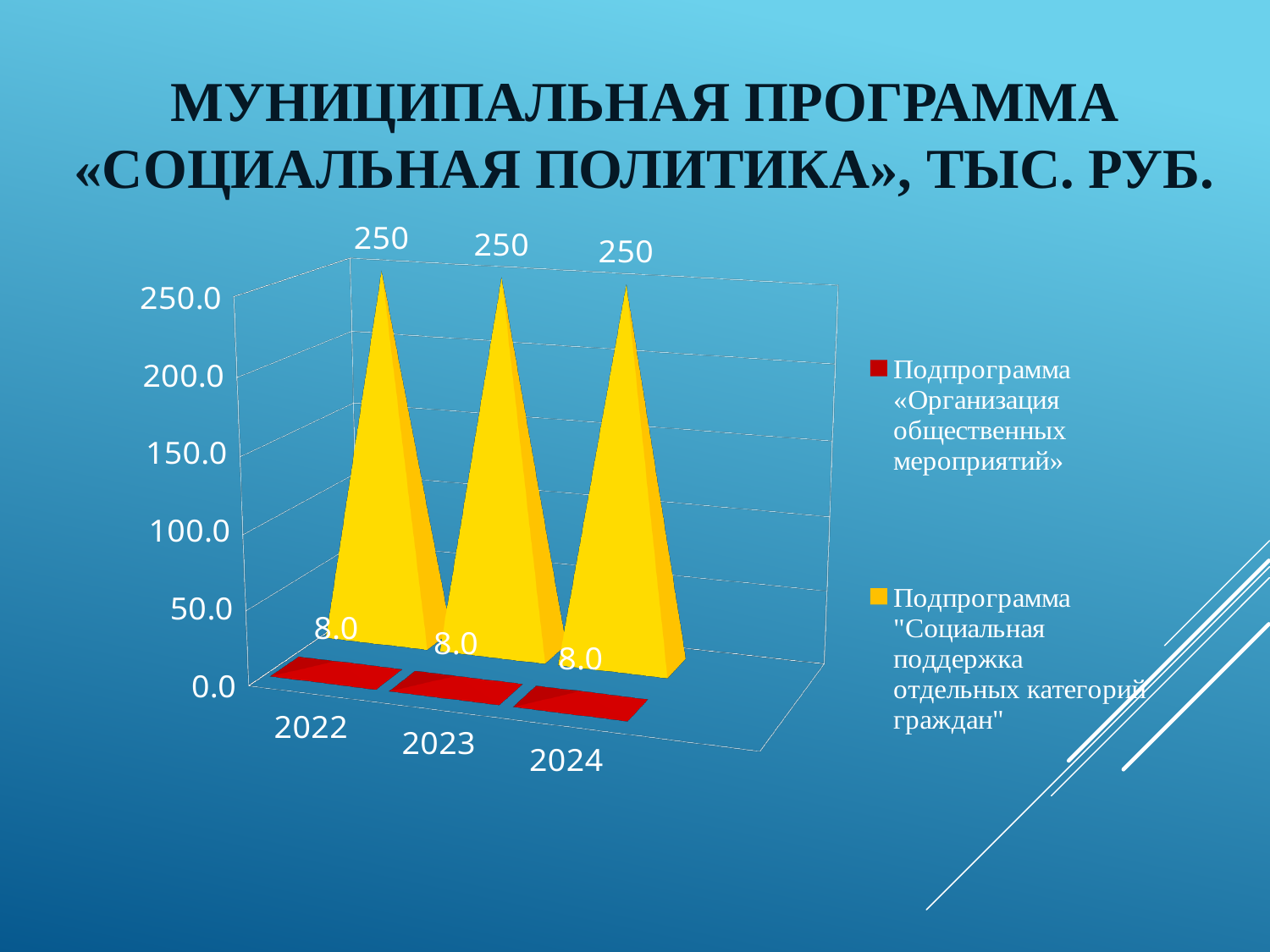
How many years are shown on the x axis? 3 Does the value for the subprogramme "Социальная поддержка отдельных категорий граждан" rise, fall or stay the same from 2022 to 2024? Stays the same Which subprogramme has the larger value in 2023? Подпрограмма "Социальная поддержка отдельных категорий граждан" What is the value for the subprogramme «Организация общественных мероприятий» in 2024? 8.0 What is the difference between the two subprogrammes' values in 2022? 242 What kind of chart is shown on the slide? Bar chart What is the title of the chart? МУНИЦИПАЛЬНАЯ ПРОГРАММА «СОЦИАЛЬНАЯ ПОЛИТИКА», ТЫС. РУБ. What is the value for the subprogramme «Организация общественных мероприятий» in 2022? 8.0 What is the value for the subprogramme "Социальная поддержка отдельных категорий граждан" in 2024? 250 What is the value for the subprogramme "Социальная поддержка отдельных категорий граждан" in 2023? 250 How many series does the legend list? 2 Which colour represents the subprogramme «Организация общественных мероприятий»? Red